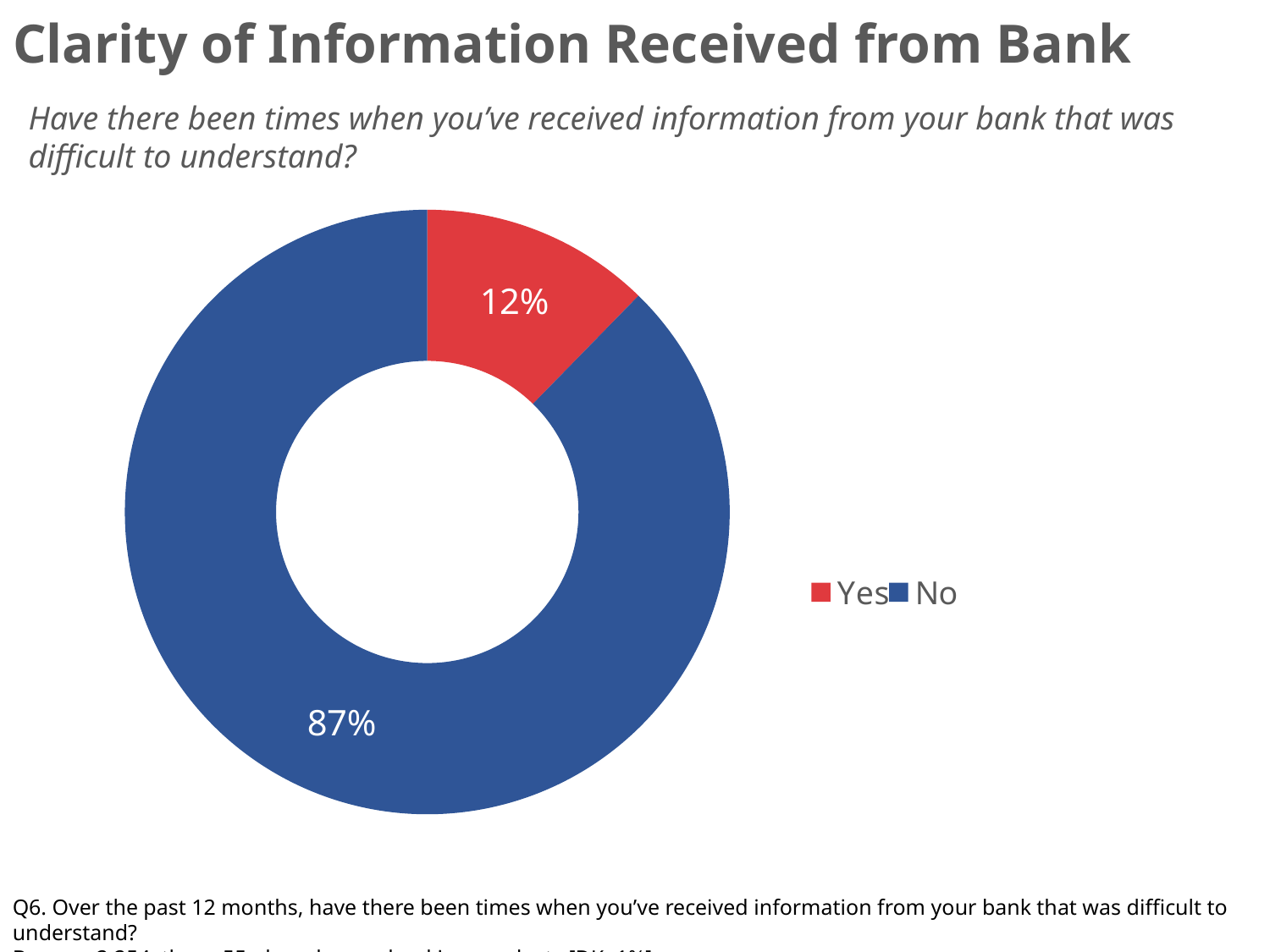
What percentage of respondents answered No? 87% How many entries does the legend list? 2 Which response has the largest share of the chart? No Which response has the smallest share of the chart? Yes How many categories does the chart show? 2 Which is larger, the share for Yes or the share for No? No What share of the chart does the Yes slice represent? 12% What colour is the Yes slice? Red What is the title of the slide? Clarity of Information Received from Bank What percentage of respondents answered Yes? 12% What is the difference in percentage points between the No and Yes responses? 75 What kind of chart is shown on the slide? Pie chart (donut)